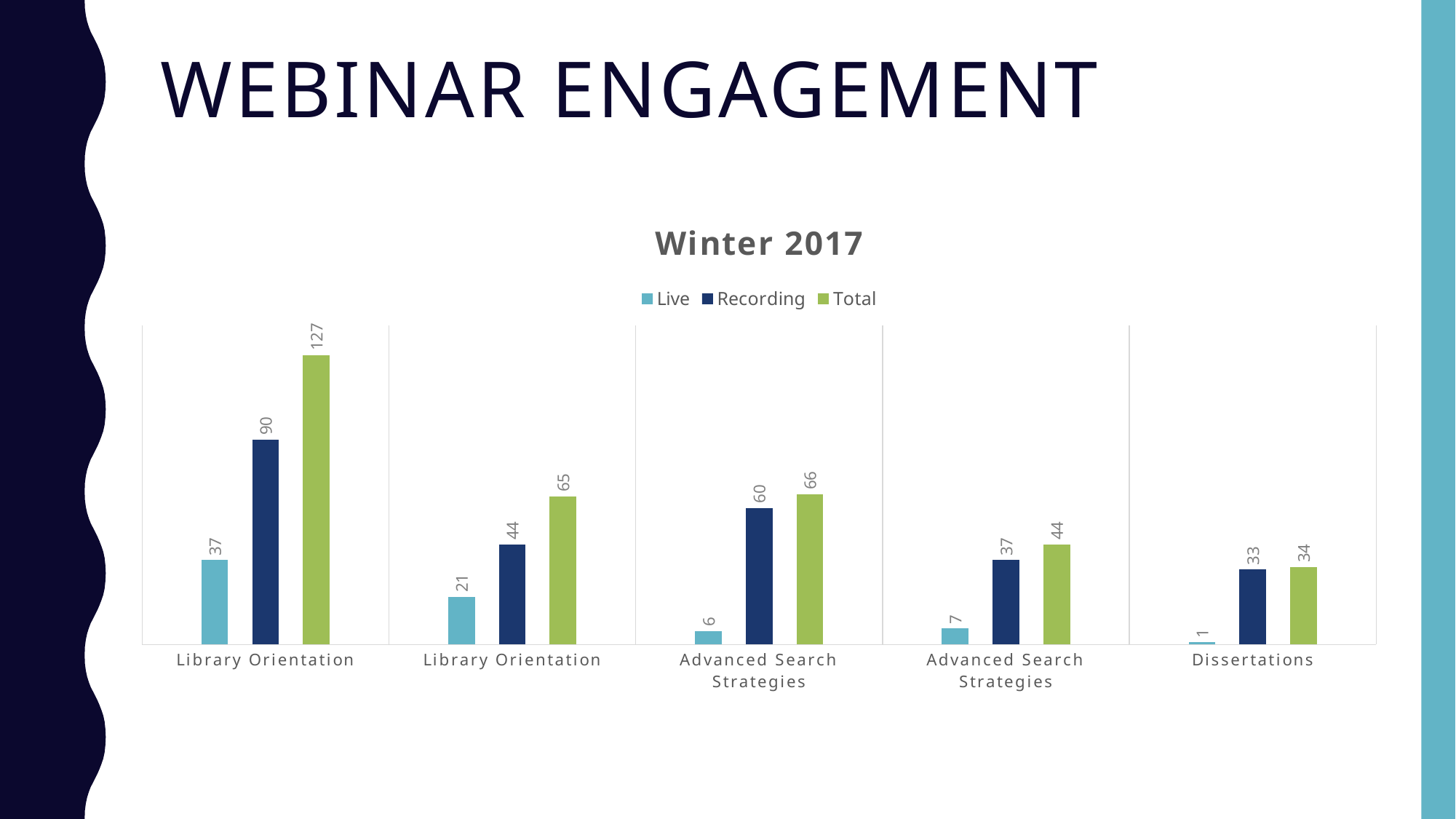
Which category group has the highest Total value? Library Orientation (the first, leftmost group) What is the Total value for the first Library Orientation group (leftmost)? 127 Which series is shown in green in the legend? Total How many series does the legend list? 3 What is the Live value for Dissertations? 1 What is the difference between the Recording and Live values in the first Library Orientation group (leftmost)? 53 Is the Recording value for the first Advanced Search Strategies group (third from left) larger or smaller than the Recording value for Dissertations? Larger Which category group has the lowest Live value? Dissertations What is the Recording value for the second Library Orientation group? 44 How many category groups are plotted along the x axis? 5 What kind of chart is shown on the slide? Bar chart What is the chart's title? Winter 2017